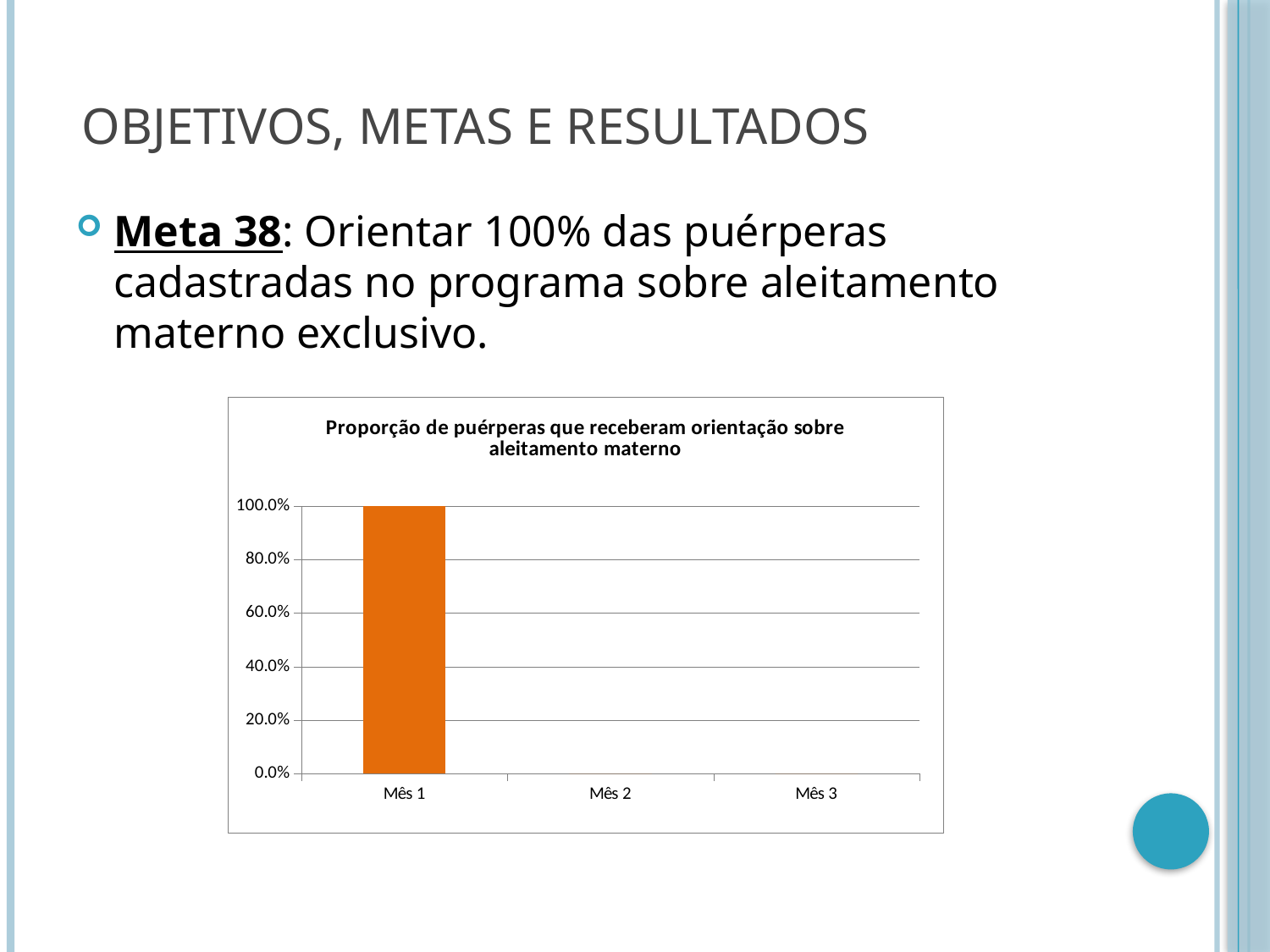
What is the value for Mês 1 in the chart? 100.0% What is the title of the chart? Proporção de puérperas que receberam orientação sobre aleitamento materno Is the value for Mês 1 greater or less than 80.0%? greater What kind of chart is shown on the slide? bar chart Is the value for Mês 3 greater or less than 20.0%? less Which is larger, the value for Mês 1 or the value for Mês 2? Mês 1 What colour is the bar for Mês 1? orange Which category has the highest value in the chart? Mês 1 Do the values rise or fall from Mês 1 to Mês 3? fall Is the value for Mês 2 greater or less than 20.0%? less How many categories are shown on the x axis of the chart? 3